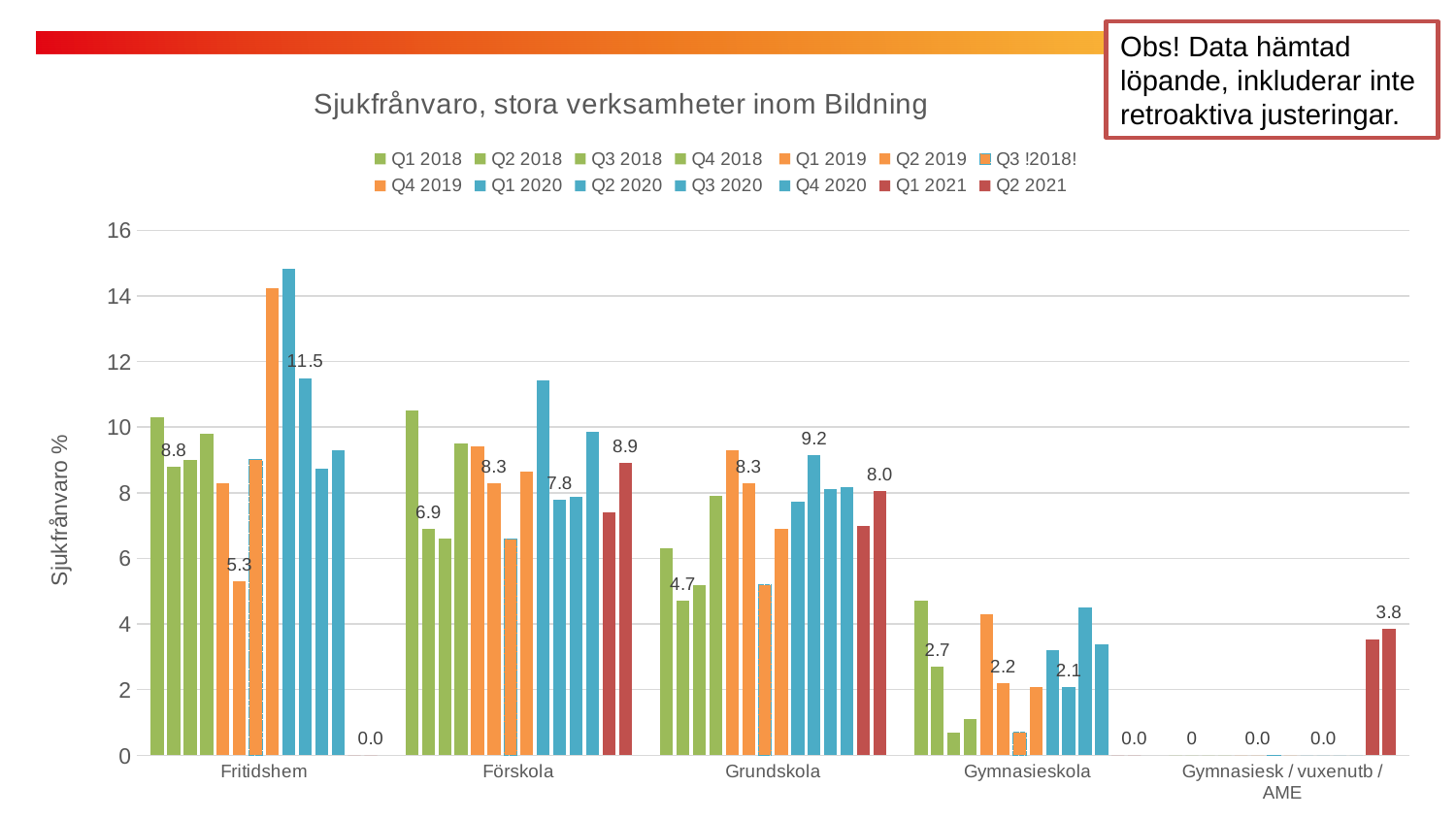
How many categories are shown on the x axis of the chart? 5 What kind of chart is shown on the slide? bar chart What is the title of the chart? Sjukfrånvaro, stora verksamheter inom Bildning What is the value for Q2 2021 in the Gymnasiesk / vuxenutb / AME category? 3.8 How many series does the legend list? 14 What is the difference between the Q2 2021 values for Förskola and Grundskola? 0.9 Is the value for Q1 2020 in the Fritidshem category greater or less than 14? greater What is the value for Q2 2021 in the Förskola category? 8.9 Which has the larger Q2 2018 value, Fritidshem or Förskola? Fritidshem What is the value for Q2 2020 in the Fritidshem category? 11.5 Which category has the highest Q2 2020 value? Fritidshem What is the value for Q2 2019 in the Gymnasieskola category? 2.2